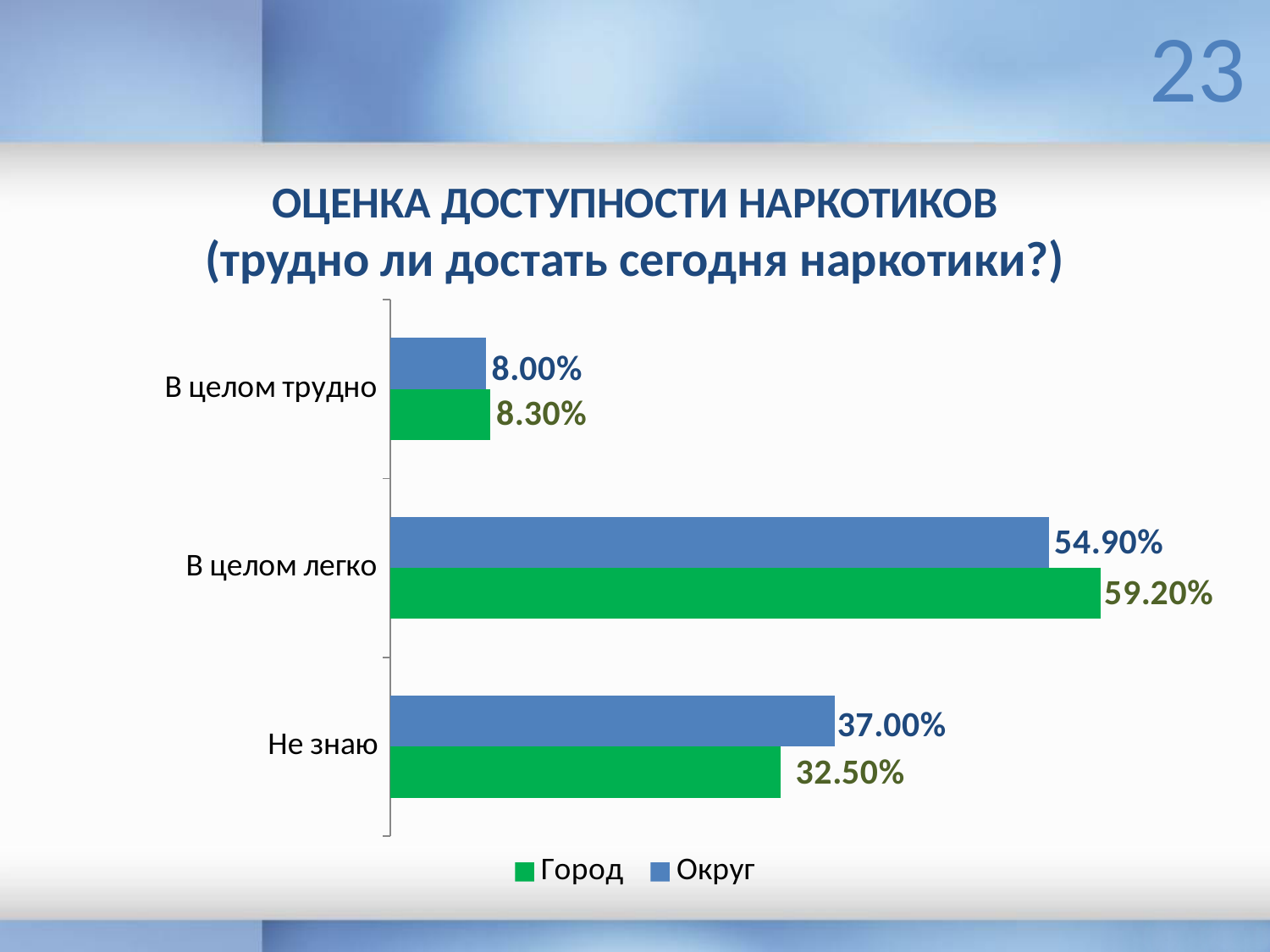
How many categories are shown on the chart? 3 What is the value for Округ in the category В целом трудно? 8.00% Which category has the highest value for the Город series? В целом легко What is the difference between the Город and Округ values in the category В целом легко? 4.30% In the category Не знаю, which series has the larger value, Город or Округ? Округ Which category has the lowest value for the Округ series? В целом трудно Which colour represents the Город series in the chart? Green What is the value for Город in the category В целом легко? 59.20% What kind of chart is shown on the slide? Bar chart What is the value for Город in the category Не знаю? 32.50% How many series does the legend list? 2 What is the value for Округ in the category Не знаю? 37.00%